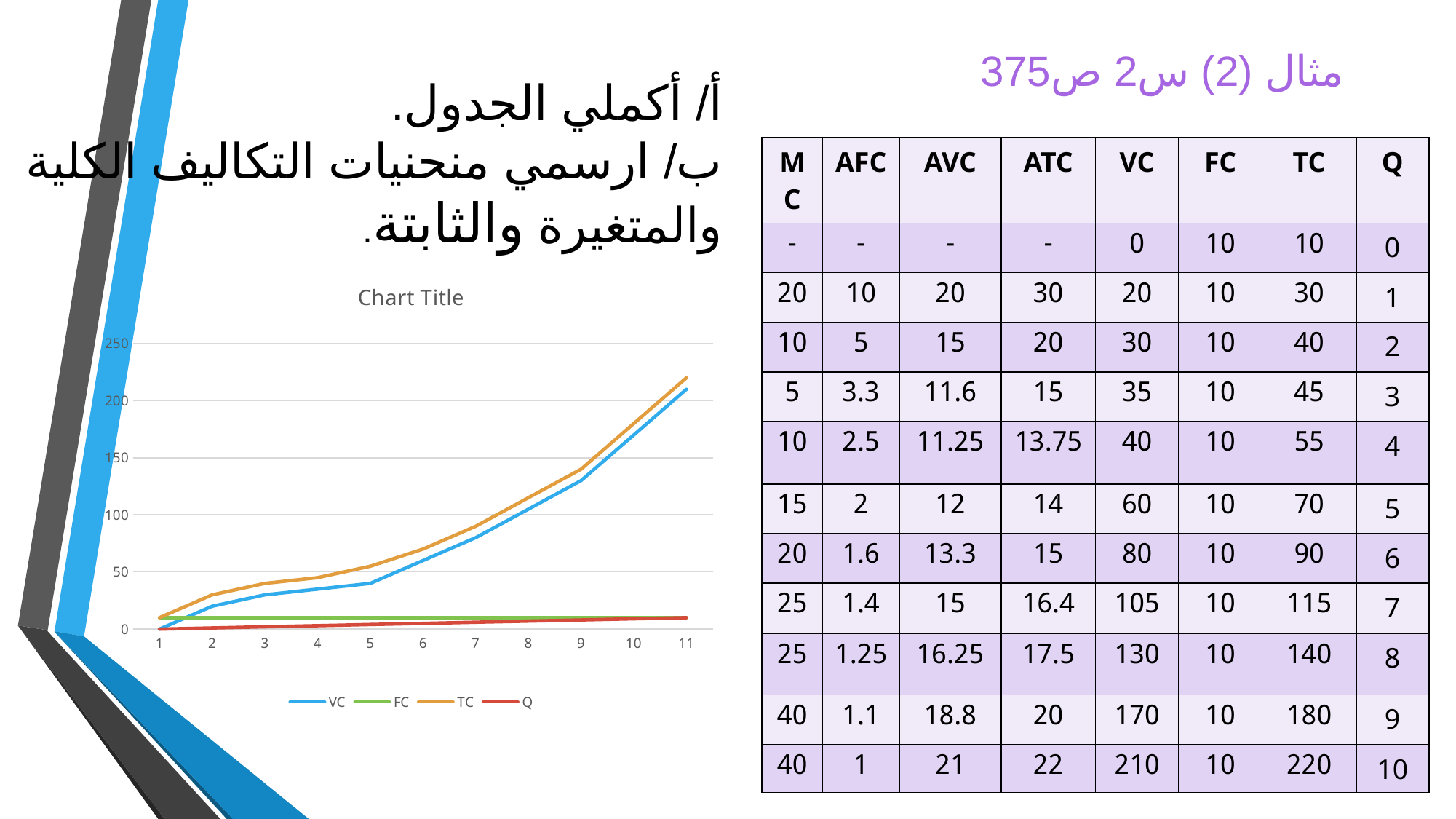
Which series are listed in the chart legend? VC, FC, TC, Q Is the value of the VC series at x = 5 greater or less than 50? less Which series reaches the highest value at x = 11? TC Is the value of the TC series at x = 9 greater or less than 100? greater Does the TC series rise or fall as x increases from 1 to 11? rise At x = 8, which series has the larger value, TC or FC? TC What kind of chart is shown on the slide? line chart How many series does the chart legend list? 4 Is the value of the TC series at x = 11 greater or less than 200? greater How many points are labelled along the x axis of the chart? 11 What is the title shown above the chart? Chart Title